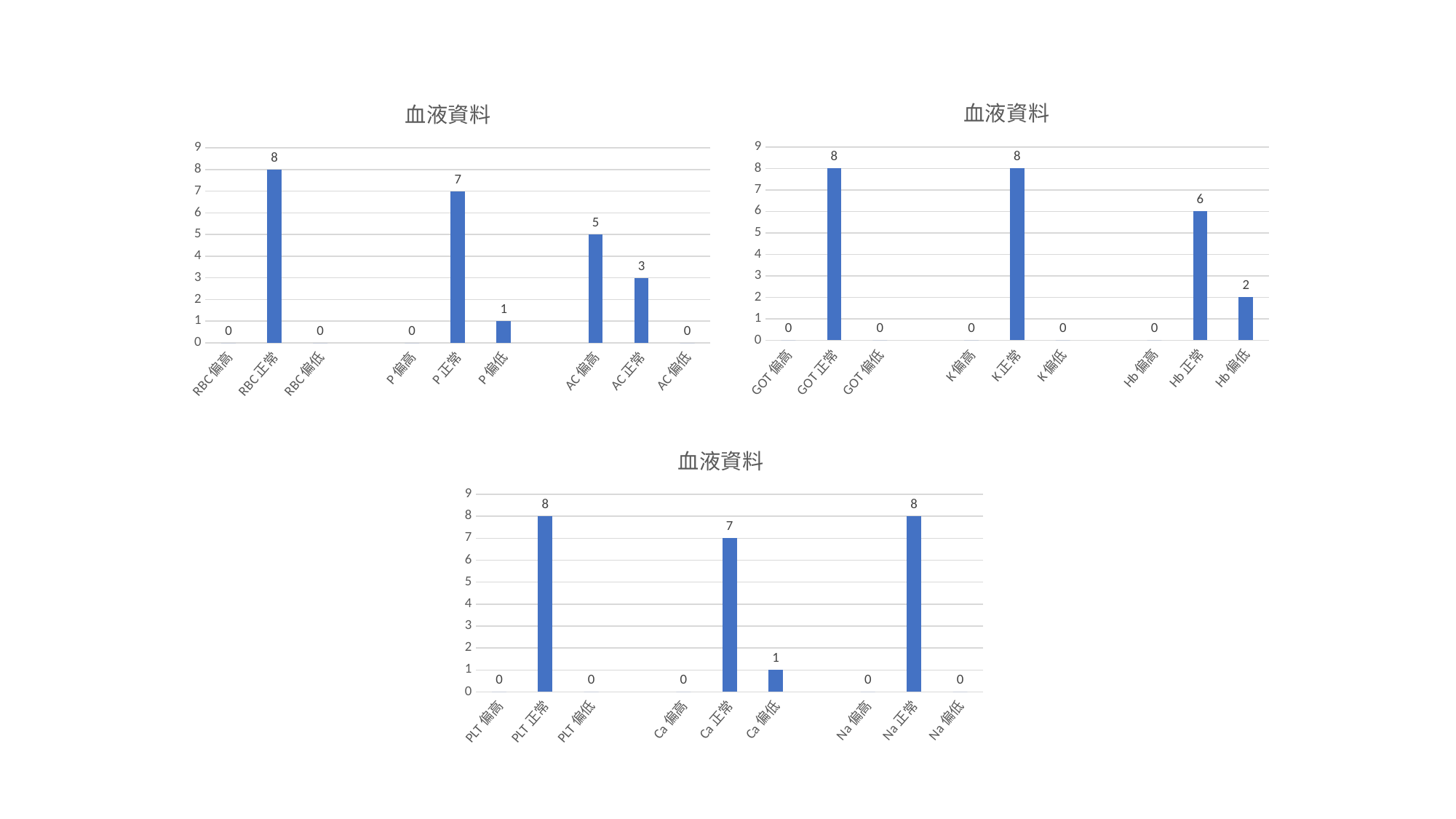
What is the title of the top-right chart? 血液資料 In the top-left chart, what is the value for AC 偏高? 5 In the top-left chart, which is larger, AC 偏高 or AC 正常? AC 偏高 In the bottom chart, which category has the lowest non-zero value? Ca 偏低 In the bottom chart, what is the value for Ca 正常? 7 In the top-left chart, what is the value for RBC 正常? 8 In the top-right chart, what is the value for Hb 偏低? 2 In the bottom chart, how many categories are shown on the x axis? 9 In the top-right chart, what is the difference between K 正常 and Hb 正常? 2 In the top-left chart, what is the difference between P 正常 and P 偏低? 6 What kind of chart is the bottom chart? Bar chart In the top-right chart, what is the value for Hb 正常? 6